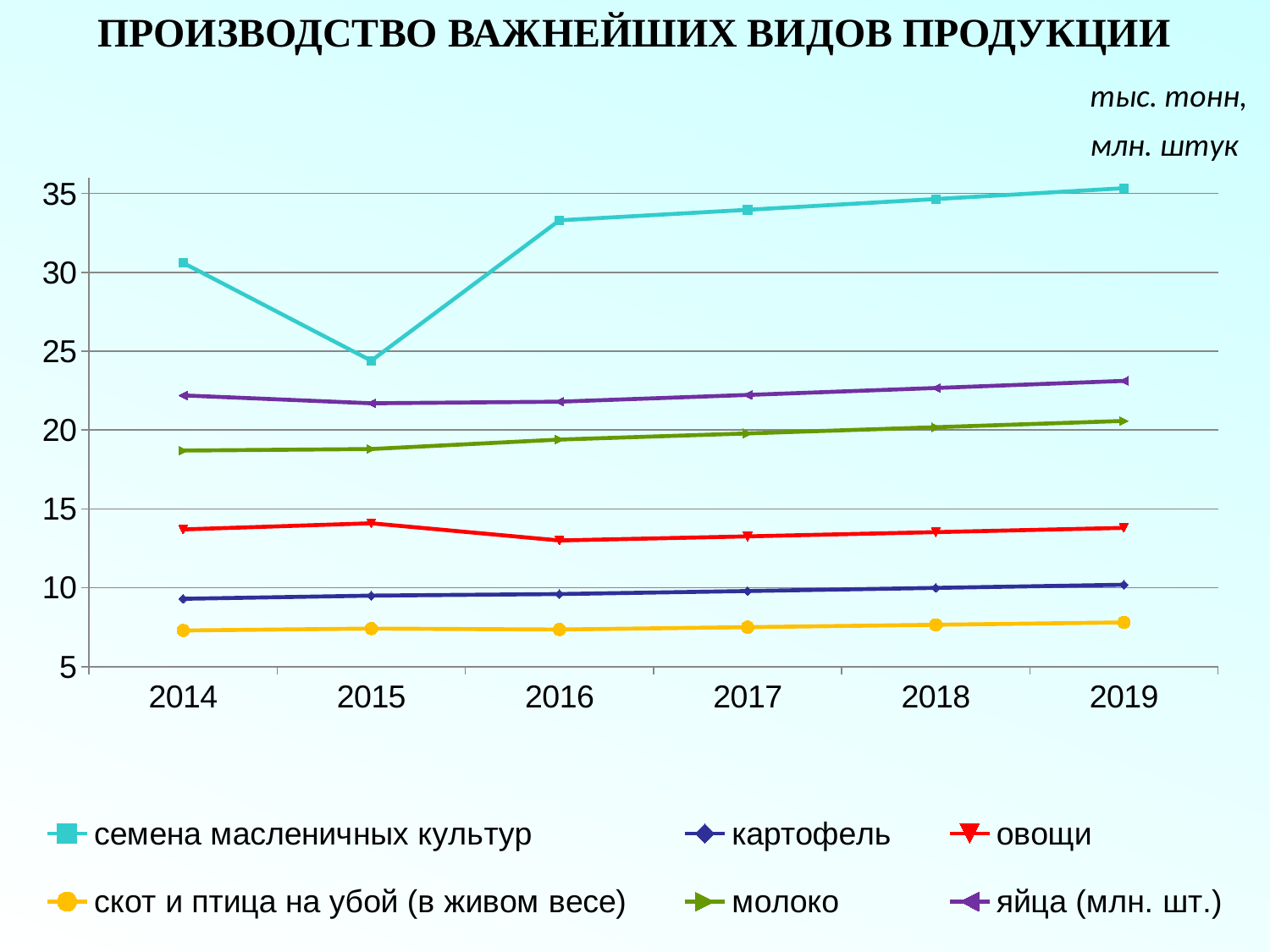
Is the value for яйца (млн. шт.) in 2014 greater or less than 20? greater How many series does the legend list? 6 Which series has the highest value in 2019? семена масленичных культур Does the value for семена масленичных культур rise or fall from 2016 to 2019? rises How many years are plotted along the x axis? 6 Is the value for семена масленичных культур in 2016 greater or less than 30? greater In 2015, which is larger: овощи or картофель? овощи Is the value for молоко in 2014 greater or less than 20? less Which series has the lowest value in 2014? скот и птица на убой (в живом весе) What kind of chart is shown on the slide? line chart